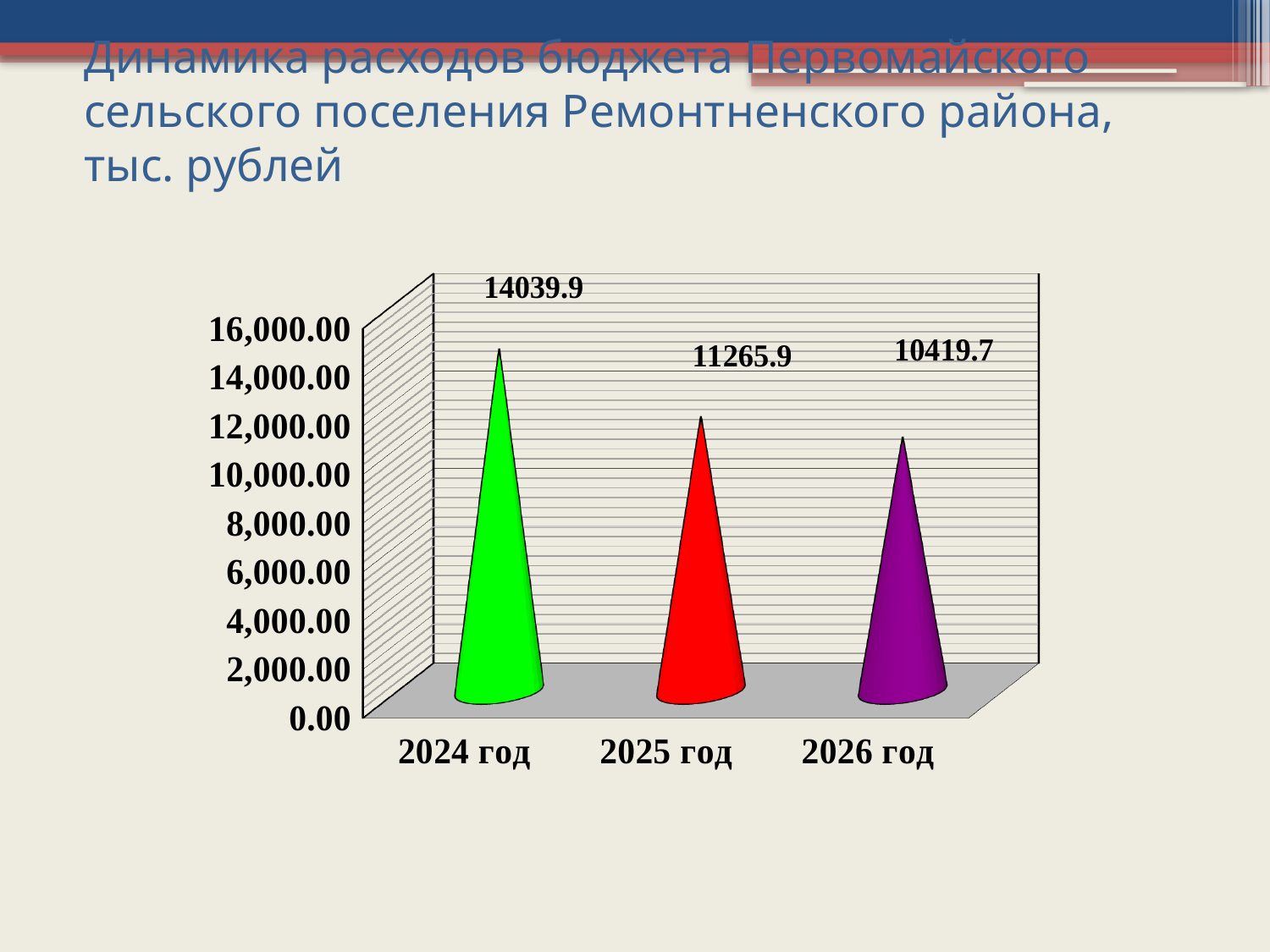
Which year has the highest value? 2024 год Is the value for 2024 год greater or less than 12,000.00? greater What is the value for 2026 год? 10419.7 Which is larger, the value for 2025 год or 2026 год? 2025 год Do the values rise or fall from 2024 год to 2026 год? fall Which year has the lowest value? 2026 год What is the value for 2025 год? 11265.9 What kind of chart is shown on the slide? bar chart What is the difference between the values for 2024 год and 2025 год? 2774 What is the value for 2024 год? 14039.9 How many years are shown on the chart? 3 What is the difference between the values for 2025 год and 2026 год? 846.2